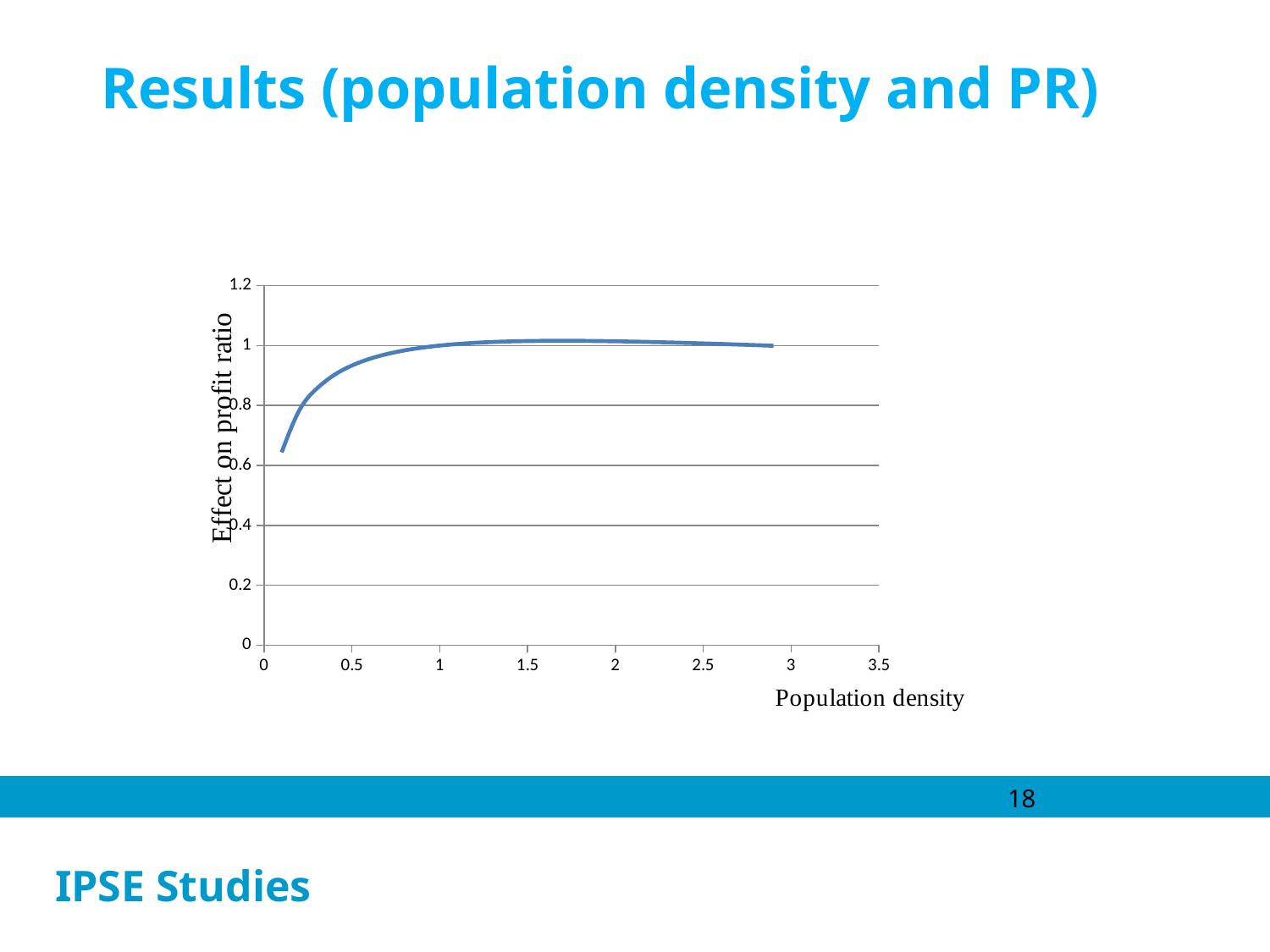
How many lines are plotted on the chart? 1 What kind of chart is shown on the slide? line chart Is the effect on profit ratio at the left end of the curve (lowest population density) greater or less than 0.6? greater Is the effect on profit ratio at a population density of 2 greater or less than 0.8? greater What is the label of the y axis? Effect on profit ratio Is the effect on profit ratio at a population density of 0.5 greater or less than 0.8? greater Which is larger: the effect on profit ratio at a population density of 0.5 or at a population density of 2? at 2 Does the effect on profit ratio rise or fall as population density increases from 0 to 1? rise What is the highest value shown on the y axis? 1.2 What is the label of the x axis? Population density